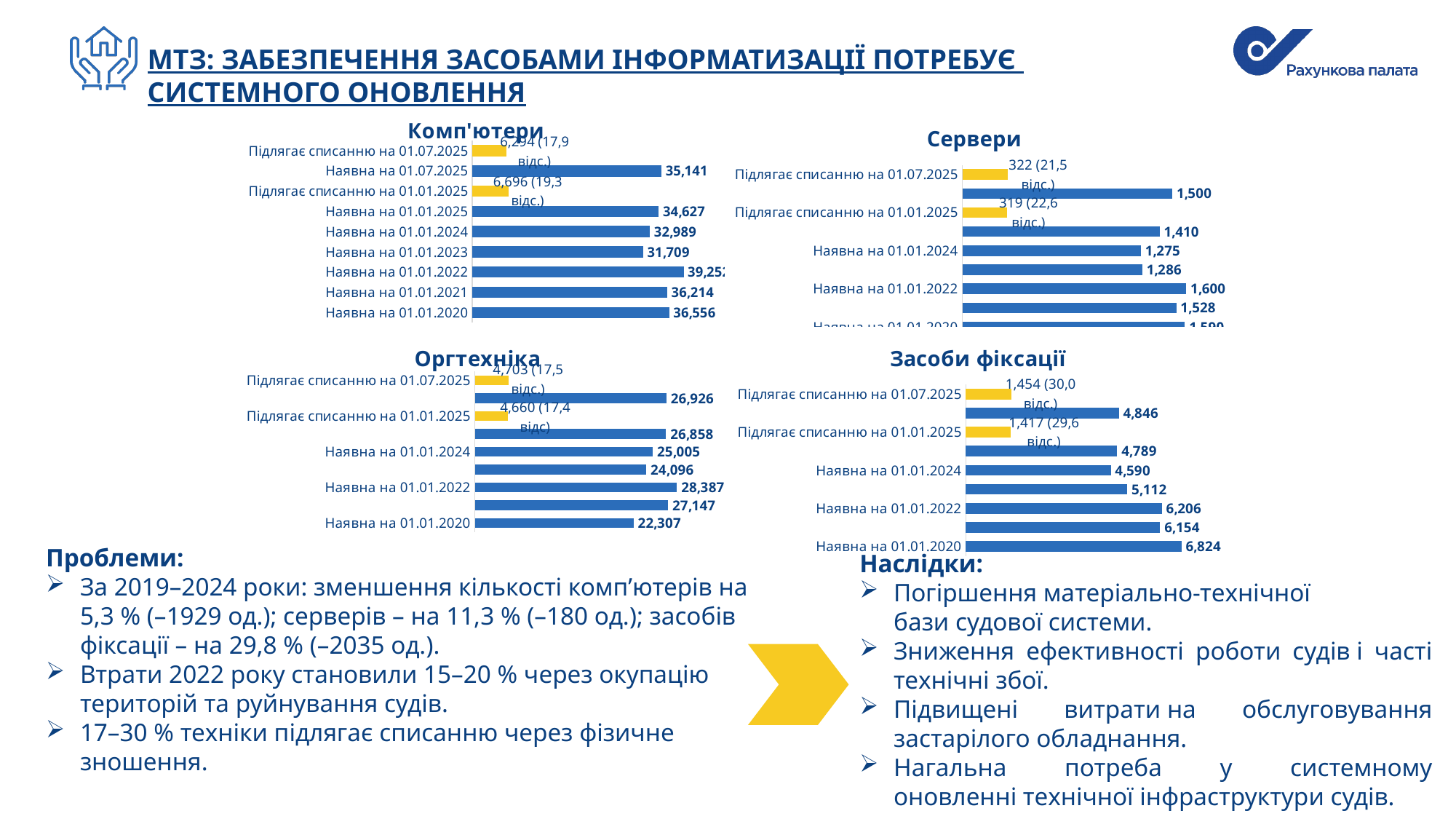
On the Сервери chart, what is the value for Підлягає списанню на 01.07.2025? 322 (21,5 відс.) On the Комп'ютери chart, what is the value for Наявна на 01.07.2025? 35,141 On the Засоби фіксації chart, which category has the highest value? Наявна на 01.01.2020 On the Комп'ютери chart, what is the value for Наявна на 01.01.2020? 36,556 On the Оргтехніка chart, what is the value for Наявна на 01.01.2024? 25,005 On the Сервери chart, what is the value for Наявна на 01.01.2022? 1,600 On the Засоби фіксації chart, what is the value for Підлягає списанню на 01.01.2025? 1,417 (29,6 відс.) On the Оргтехніка chart, which of the Наявна categories has the lowest value? Наявна на 01.01.2020 On the Сервери chart, which is larger: Наявна на 01.01.2022 or Наявна на 01.01.2024? Наявна на 01.01.2022 What type of chart is the Засоби фіксації chart? Bar chart How many charts are shown on the slide? 4 On the Комп'ютери chart, what is the difference between Наявна на 01.01.2020 and Наявна на 01.01.2024? 3,567